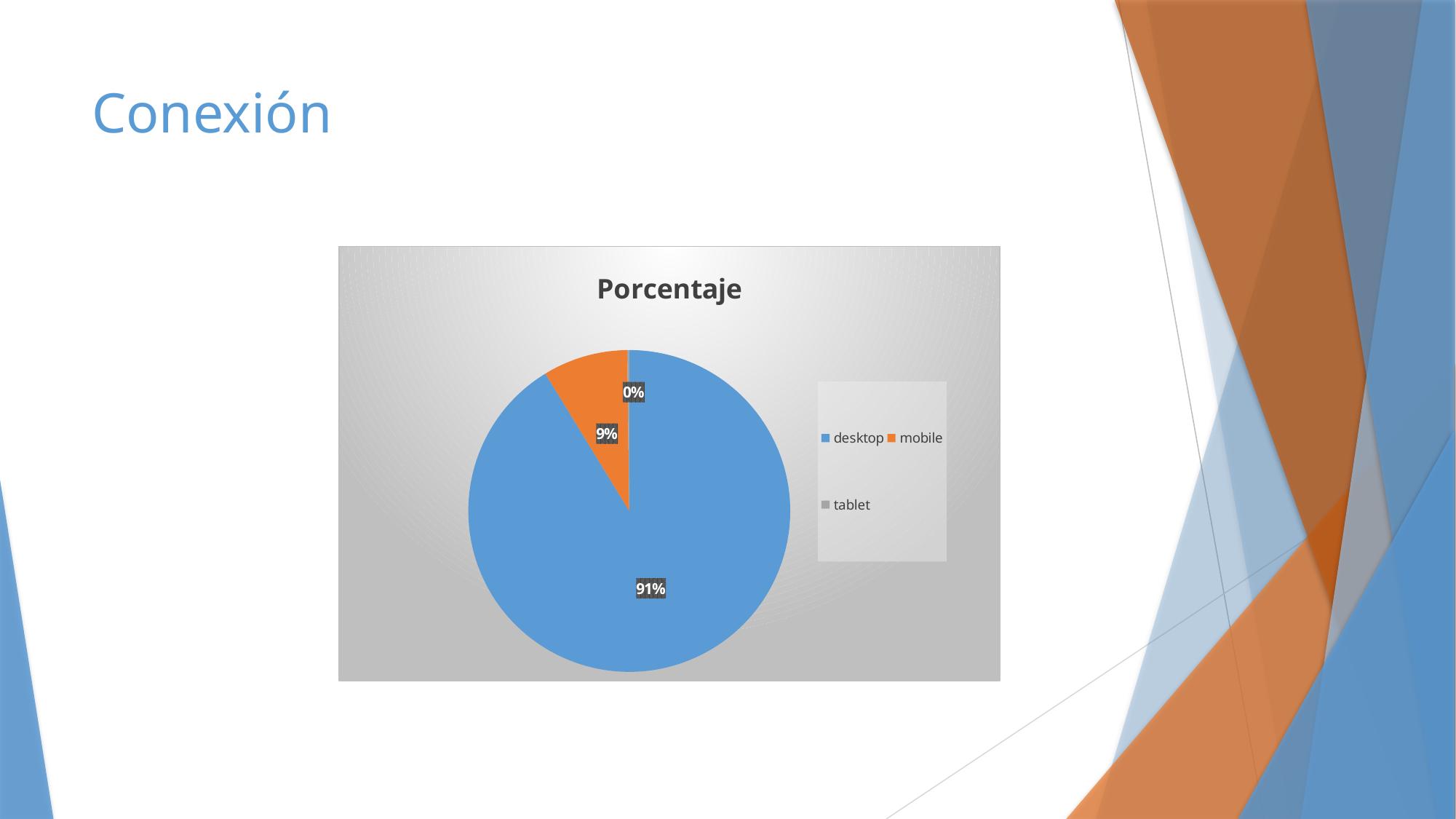
What percentage of the pie does tablet account for? 0% Which category has the smallest share of the pie? tablet Which is larger, the share for mobile or the share for tablet? mobile What percentage of the pie does mobile account for? 9% What is the title of the chart? Porcentaje What kind of chart is shown on the slide? pie chart What is the difference in percentage points between desktop and mobile? 82 How many categories does the legend list? 3 Which category has the largest share of the pie? desktop Which colour represents mobile in the pie chart? orange What percentage of the pie does desktop account for? 91%